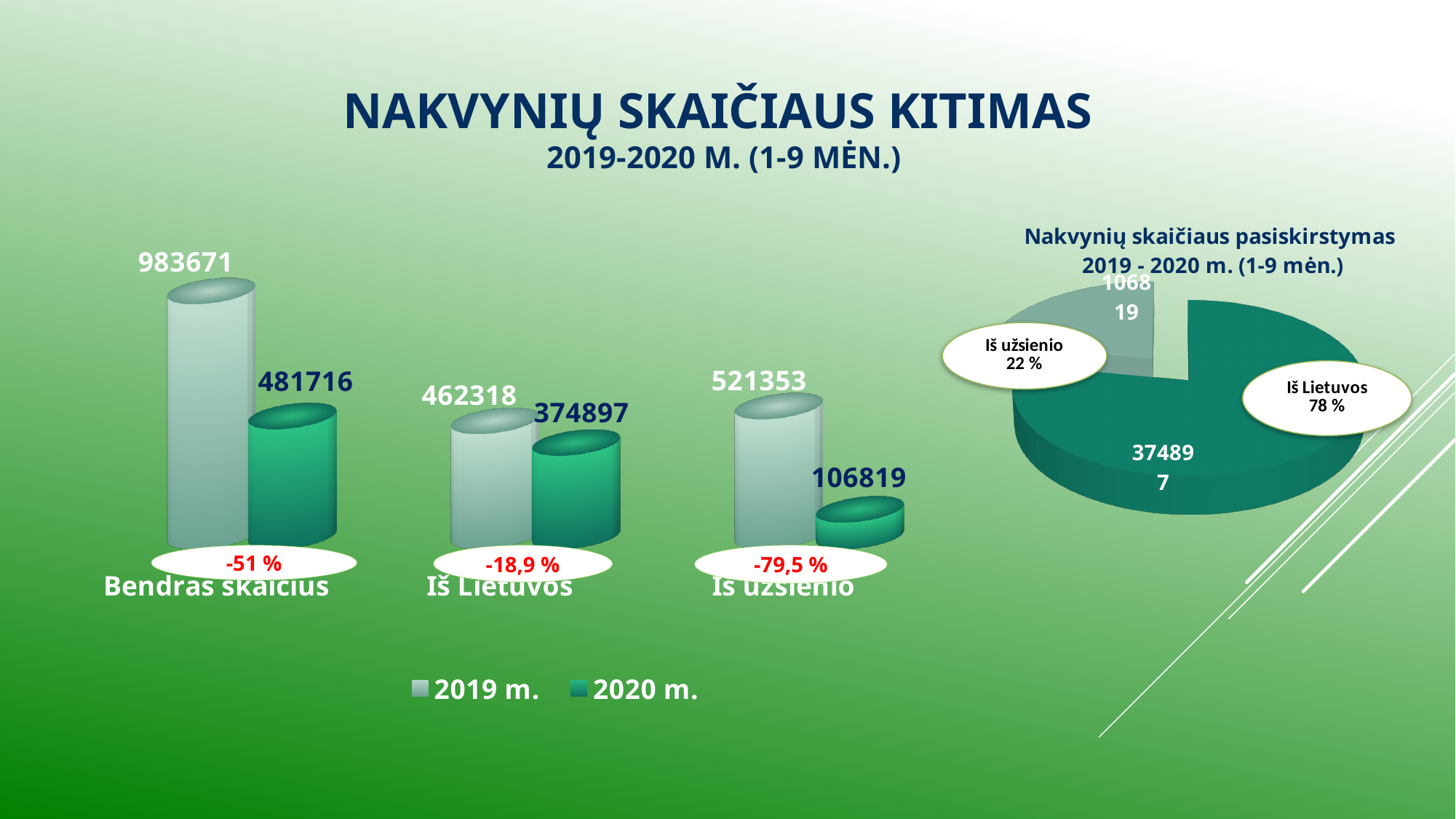
On the bar chart, what is the value for Iš užsienio in 2020 m.? 106819 On the bar chart, what is the value for Bendras skaičius in 2019 m.? 983671 How many categories are shown on the bar chart? 3 On the bar chart, what is the value for Iš Lietuvos in 2020 m.? 374897 On the bar chart, which is larger: the 2019 m. value for Iš užsienio or the 2019 m. value for Iš Lietuvos? Iš užsienio On the bar chart, which category has the lowest 2020 m. value? Iš užsienio On the bar chart, what is the difference between the 2019 m. and 2020 m. values for Iš Lietuvos? 87421 On the pie chart, what share does Iš Lietuvos have? 78 % What type of chart is the chart on the right of the slide? Pie chart On the bar chart, what percentage change is shown for Iš užsienio? -79,5 % How many series does the bar chart's legend list? 2 On the bar chart, which category has the highest 2019 m. value? Bendras skaičius